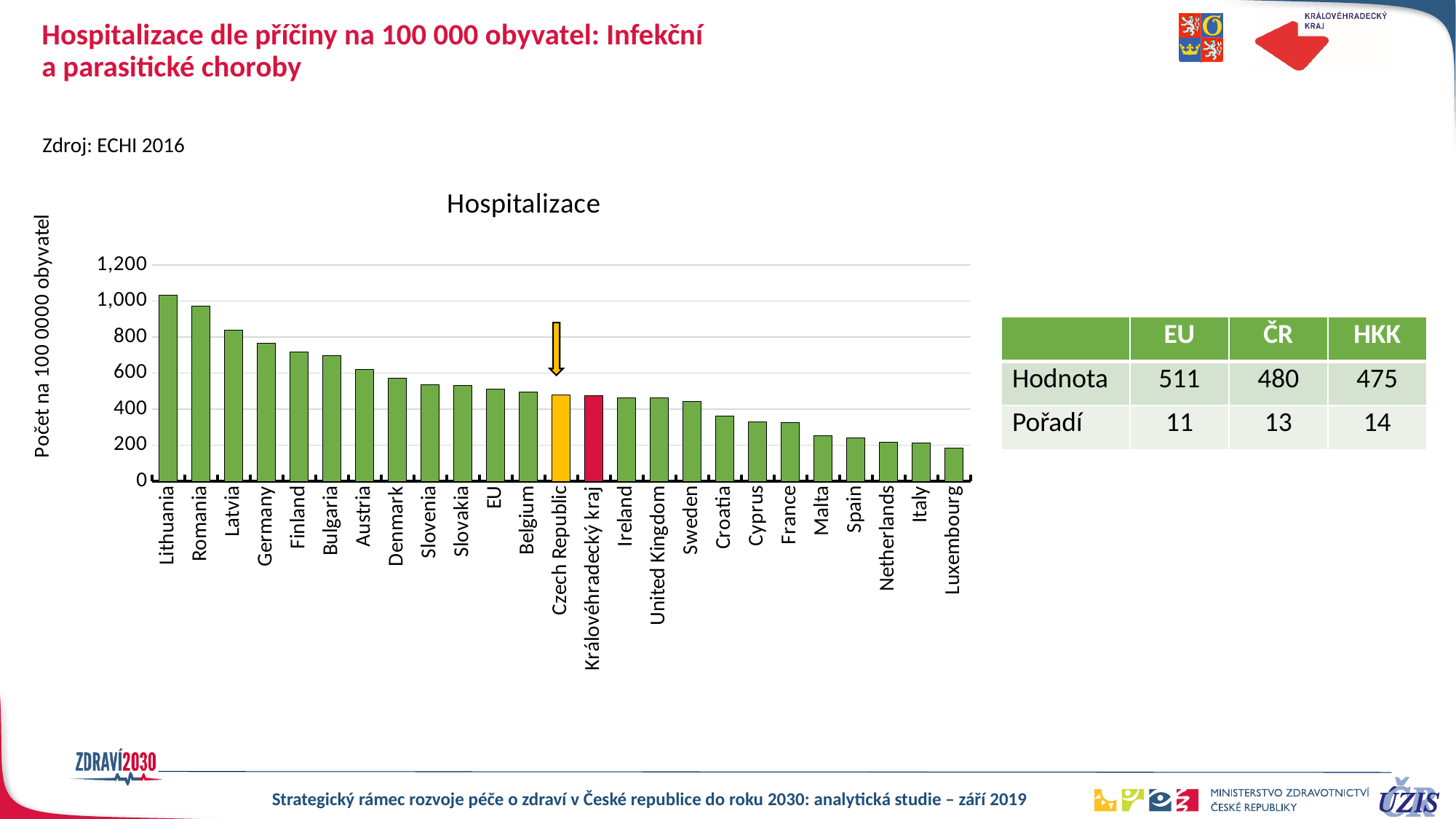
What type of chart is shown on the slide? bar chart According to the table, what is the value (Hodnota) for HKK? 475 How many categories (bars) are plotted in the Hospitalizace chart? 25 What is the difference between the EU value and the ČR value shown in the table? 31 Is the value for Romania greater or less than 1,000? less Which category has the lowest value in the Hospitalizace chart? Luxembourg According to the table, what is the value (Hodnota) for EU? 511 Is the value for Latvia greater or less than 800? greater Which category has the highest value in the Hospitalizace chart? Lithuania Do the values rise or fall moving from left to right along the x axis? fall What is the rank (Pořadí) of ČR shown in the table? 13 Is the value for Croatia greater or less than 400? less